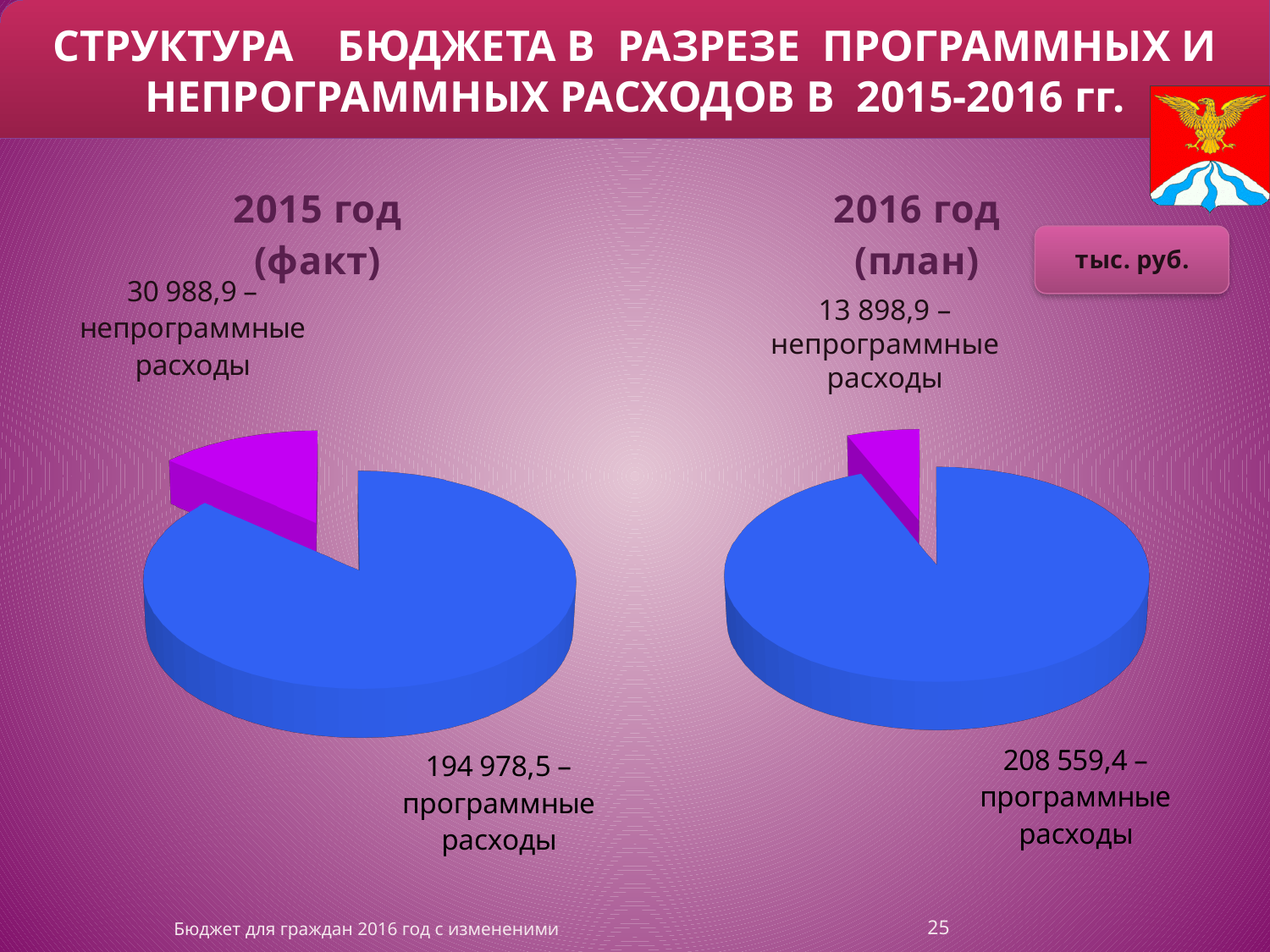
In the 2015 год (факт) pie chart, what is the value for непрограммные расходы? 30 988,9 In the 2015 год (факт) pie chart, what is the value for программные расходы? 194 978,5 In the 2015 год (факт) pie chart, which category has the largest slice? программные расходы What type of chart is used for 2015 год (факт)? pie chart In the 2016 год (план) pie chart, what is the value for программные расходы? 208 559,4 By how much do непрограммные расходы in the 2015 год (факт) chart exceed those in the 2016 год (план) chart? 17 090,0 In the 2015 год (факт) pie chart, what is the difference between программные расходы and непрограммные расходы? 163 989,6 How many slices does the 2016 год (план) pie chart have? 2 Which chart shows the larger value for программные расходы, 2015 год (факт) or 2016 год (план)? 2016 год (план) In the 2016 год (план) pie chart, which category has the smallest slice? непрограммные расходы What unit of measurement is indicated on the slide for the chart values? тыс. руб. In the 2016 год (план) pie chart, what is the value for непрограммные расходы? 13 898,9